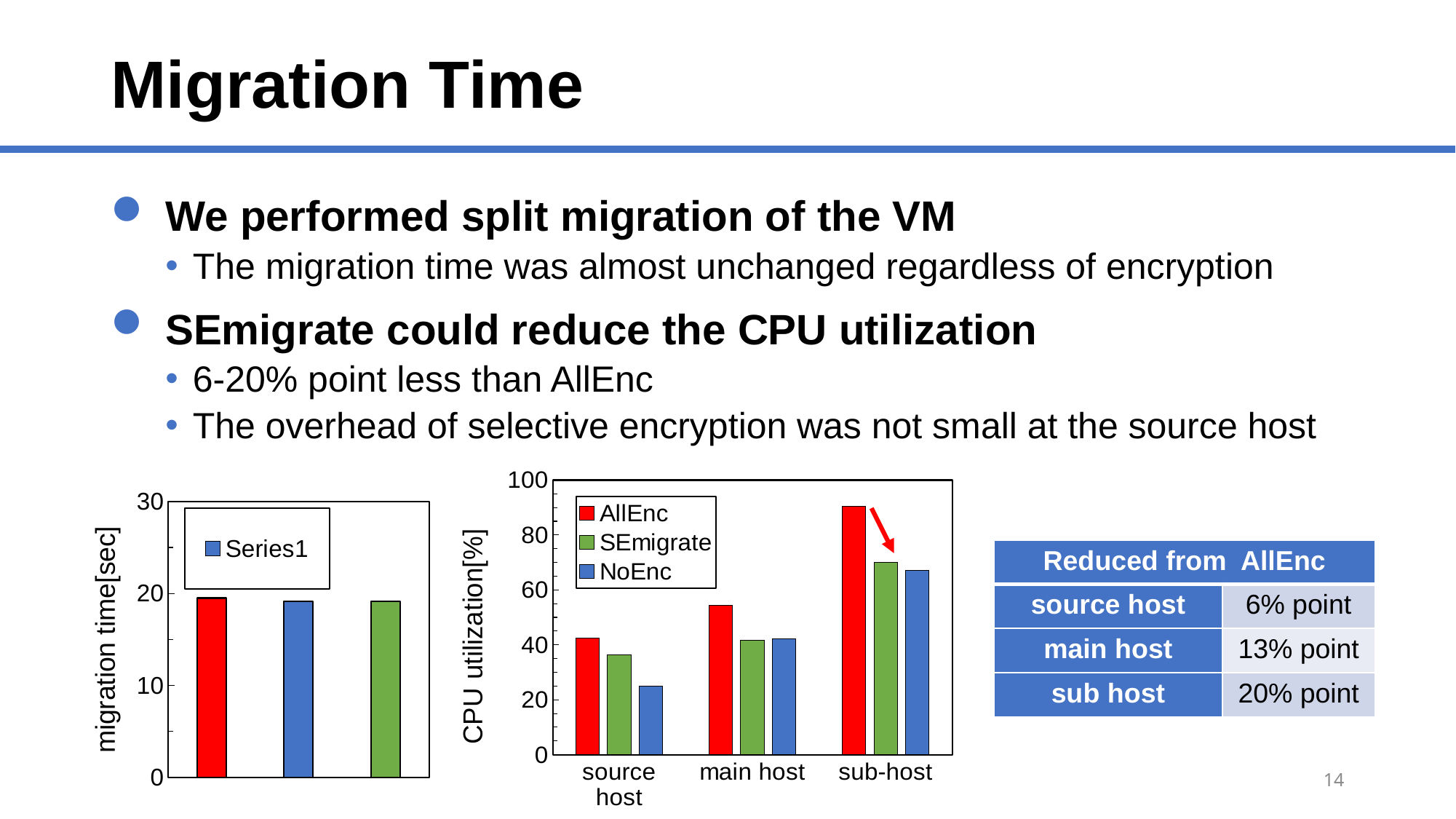
In the CPU utilization chart, which series has the lowest value at source host? NoEnc In the CPU utilization chart, what kind of chart is shown? bar chart In the migration time chart on the left, what entry does the legend show? Series1 In the CPU utilization chart, how many host categories are shown on the x axis? 3 In the migration time chart on the left, how many bars are plotted? 3 In the CPU utilization chart, which host category has the highest AllEnc value? sub-host In the CPU utilization chart, is the AllEnc value for main host greater or less than 40? greater In the migration time chart on the left, is the value of the red bar greater or less than 10? greater In the CPU utilization chart, is the NoEnc value for source host greater or less than 40? less In the CPU utilization chart, at source host, which is larger: AllEnc or NoEnc? AllEnc In the CPU utilization chart, how many series does the legend list? 3